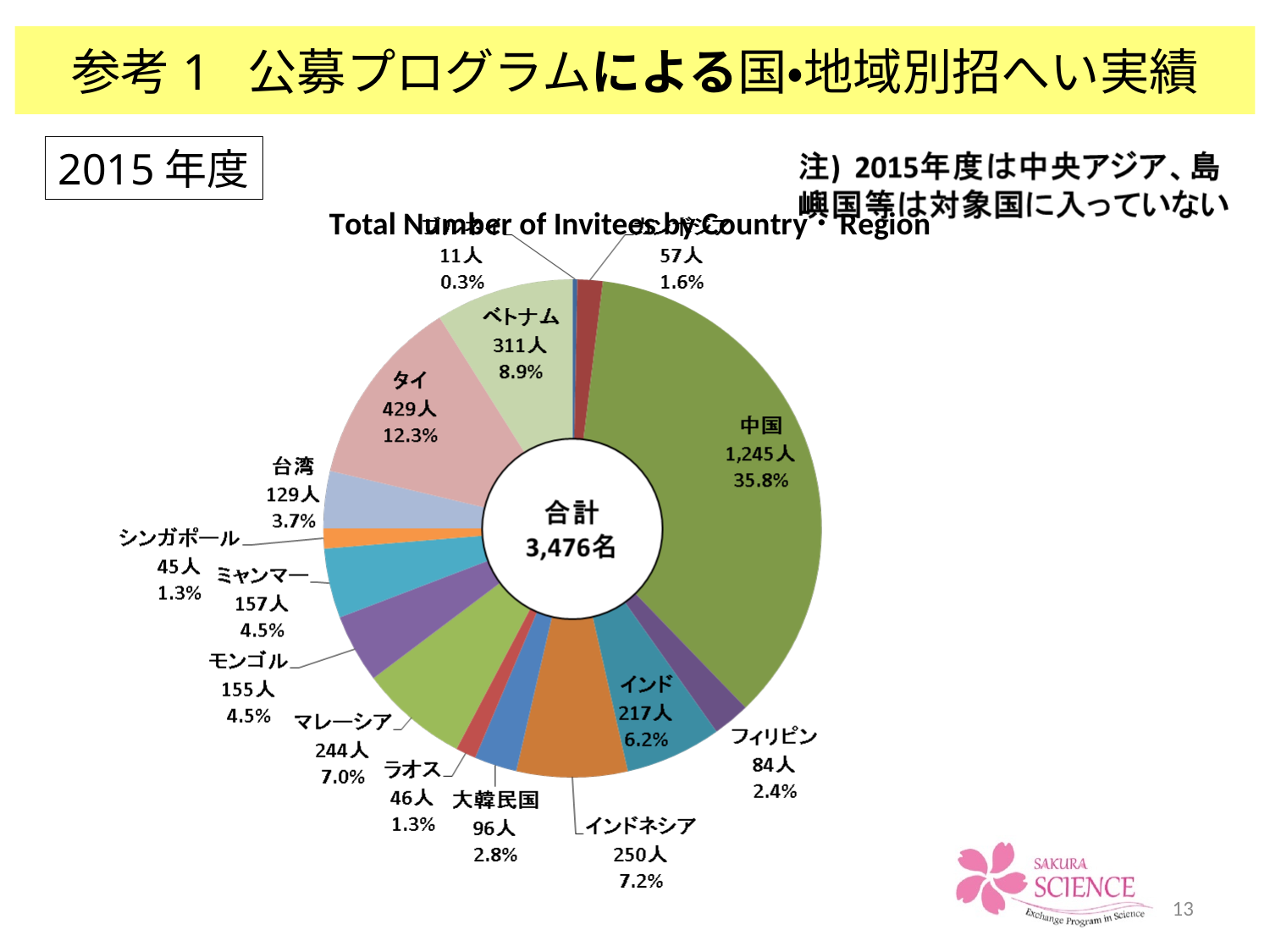
How many invitees came from 中国 according to the chart? 1,245人 Which country or region has the largest slice of the pie? 中国 What percentage share of the pie does 中国 represent? 35.8% What is the total number of invitees shown in the centre of the chart? 3,476名 Which has more invitees, インドネシア or マレーシア? インドネシア What is the difference in invitees between 中国 and タイ? 816人 What is the smallest number of invitees shown for any slice of the pie? 11人 How many invitees came from タイ? 429人 What is the English title printed above the chart? Total Number of Invitees by Country・Region How many invitees came from フィリピン? 84人 What kind of chart is shown on the slide? pie chart What is the percentage share for ベトナム? 8.9%